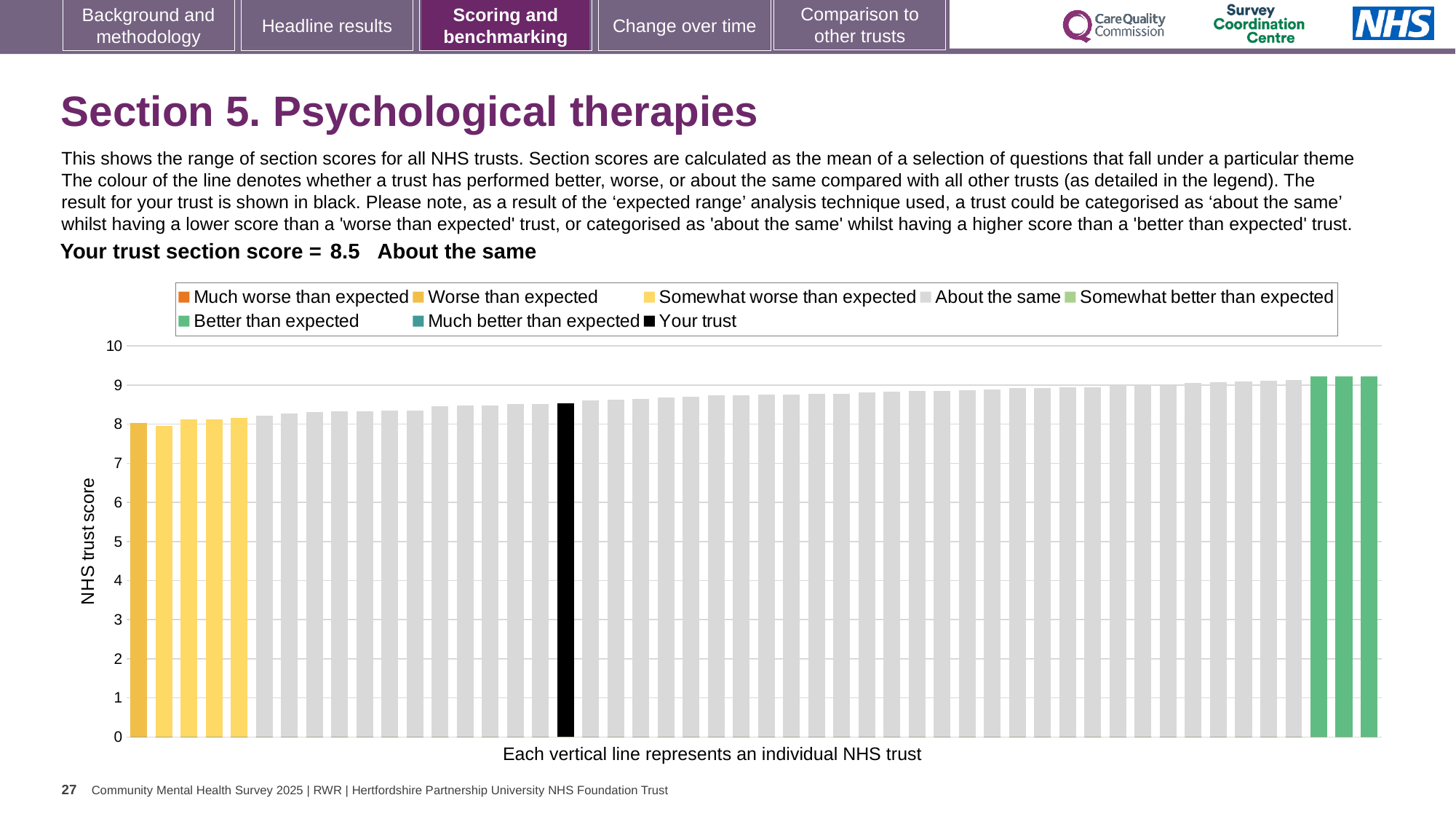
What kind of chart is shown on the slide? bar chart How many bars are coloured green ('Better than expected')? 3 Is the value of the black 'Your trust' bar greater or less than 8? greater Do the bar values rise or fall from left to right along the x axis? rise Is the value of the black 'Your trust' bar greater or less than 9? less What is the section score for your trust shown on the slide? 8.5 How many entries does the chart legend list? 8 What is the label on the vertical axis of the chart? NHS trust score Which performance category is your trust placed in for this section? About the same Is the value of the lowest bar in the chart greater or less than 7? greater What is the highest value shown on the vertical axis? 10